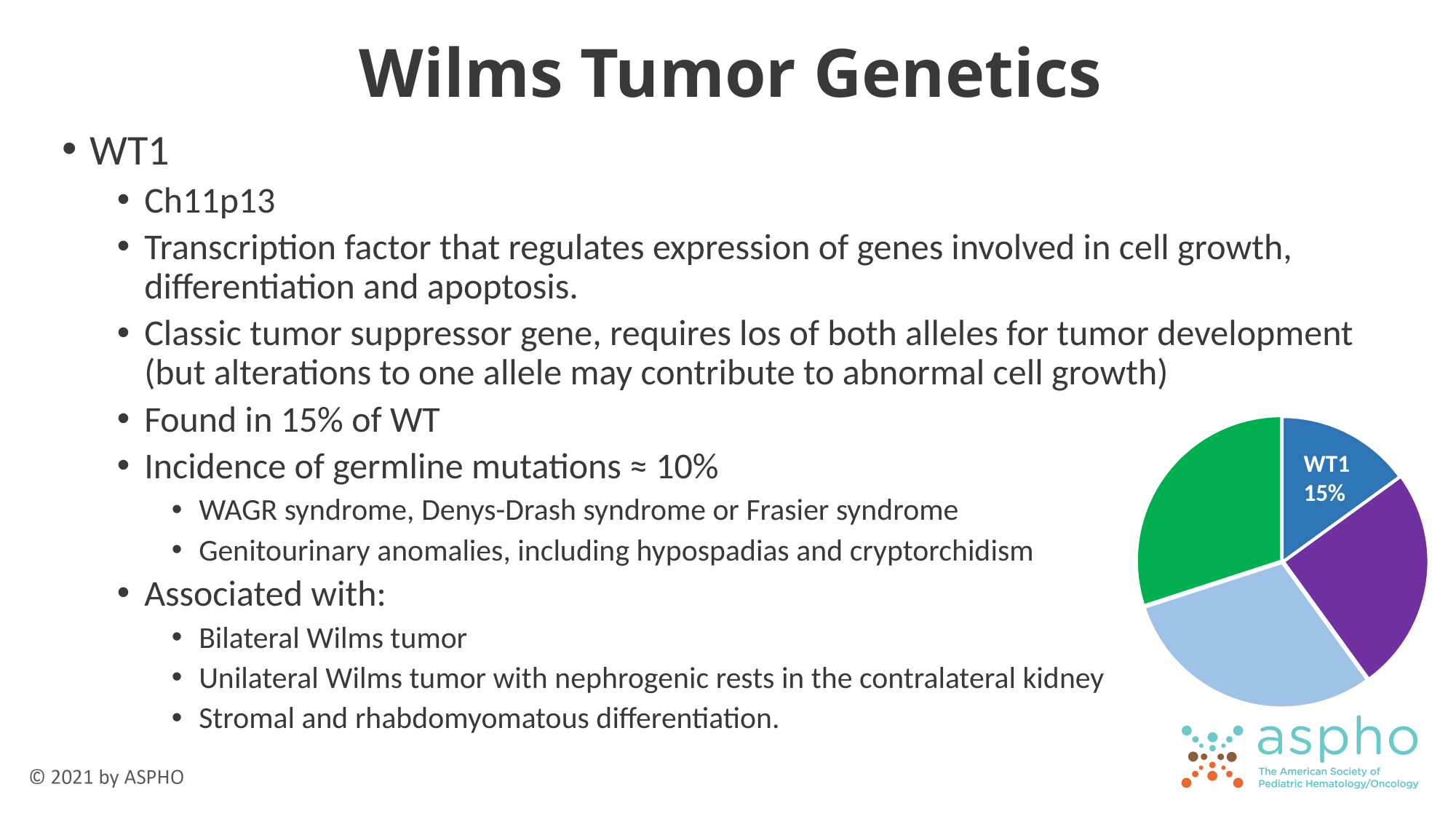
How many slices does the pie chart have? 4 What kind of chart is shown on the slide? pie chart Which slice of the pie chart is labeled? WT1 What colour is the WT1 slice in the pie chart? blue What percentage is shown for the WT1 slice of the pie chart? 15% Is the WT1 slice the smallest slice of the pie chart? yes What share of the pie does the WT1 slice represent? 15%